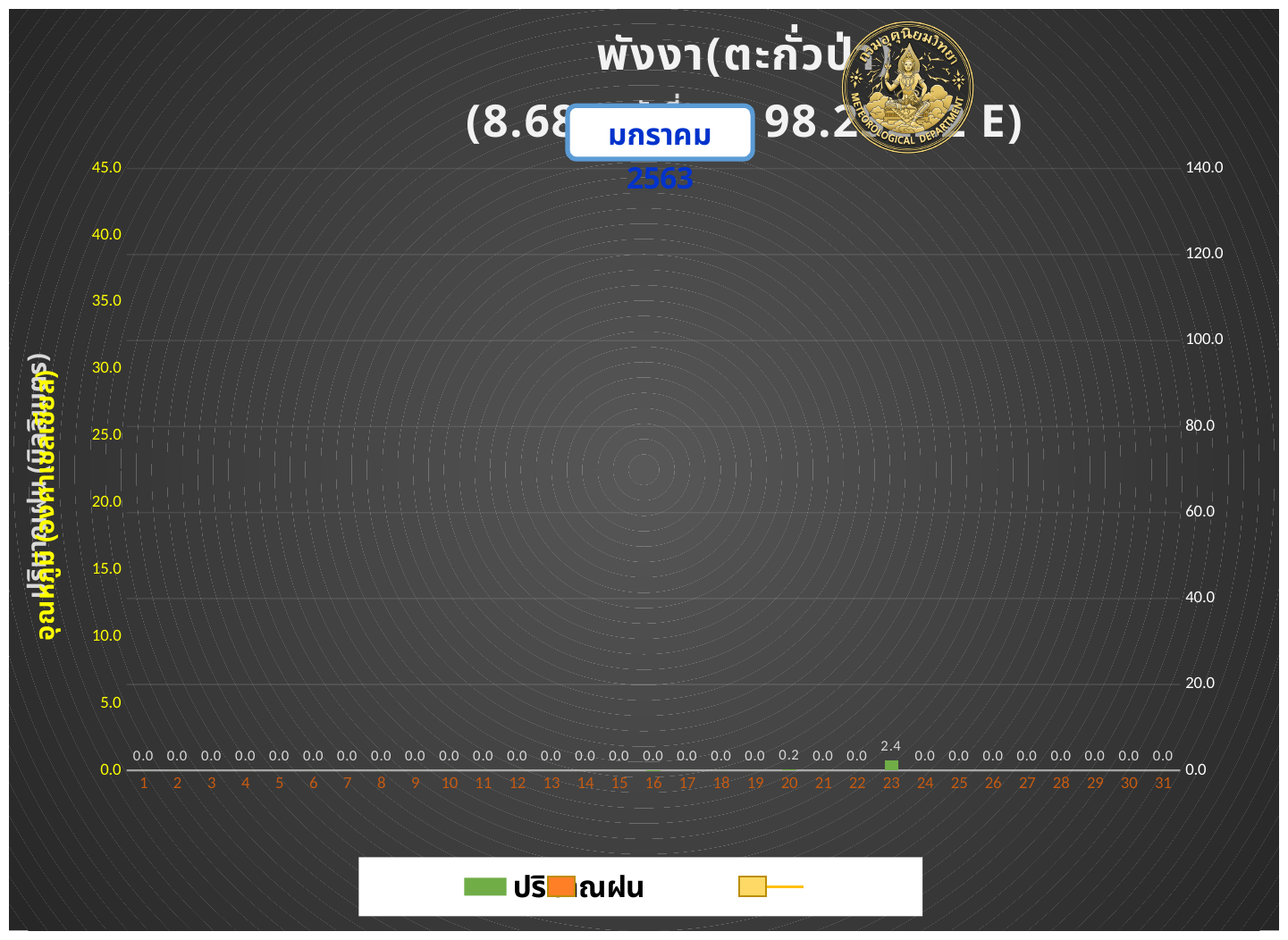
How many days are shown on the x axis? 31 What is the highest tick value on the right vertical axis? 140.0 Which day has the highest rainfall value? 23 What kind of chart is this? bar chart What is the difference between the rainfall values for day 23 and day 20? 2.2 Which has the larger rainfall value, day 20 or day 23? day 23 What is the rainfall value shown for day 23? 2.4 What is the rainfall value shown for day 20? 0.2 What is the rainfall value shown for day 1? 0.0 Is the value for day 23 greater or less than 5.0? less What is the highest tick value on the left vertical axis? 45.0